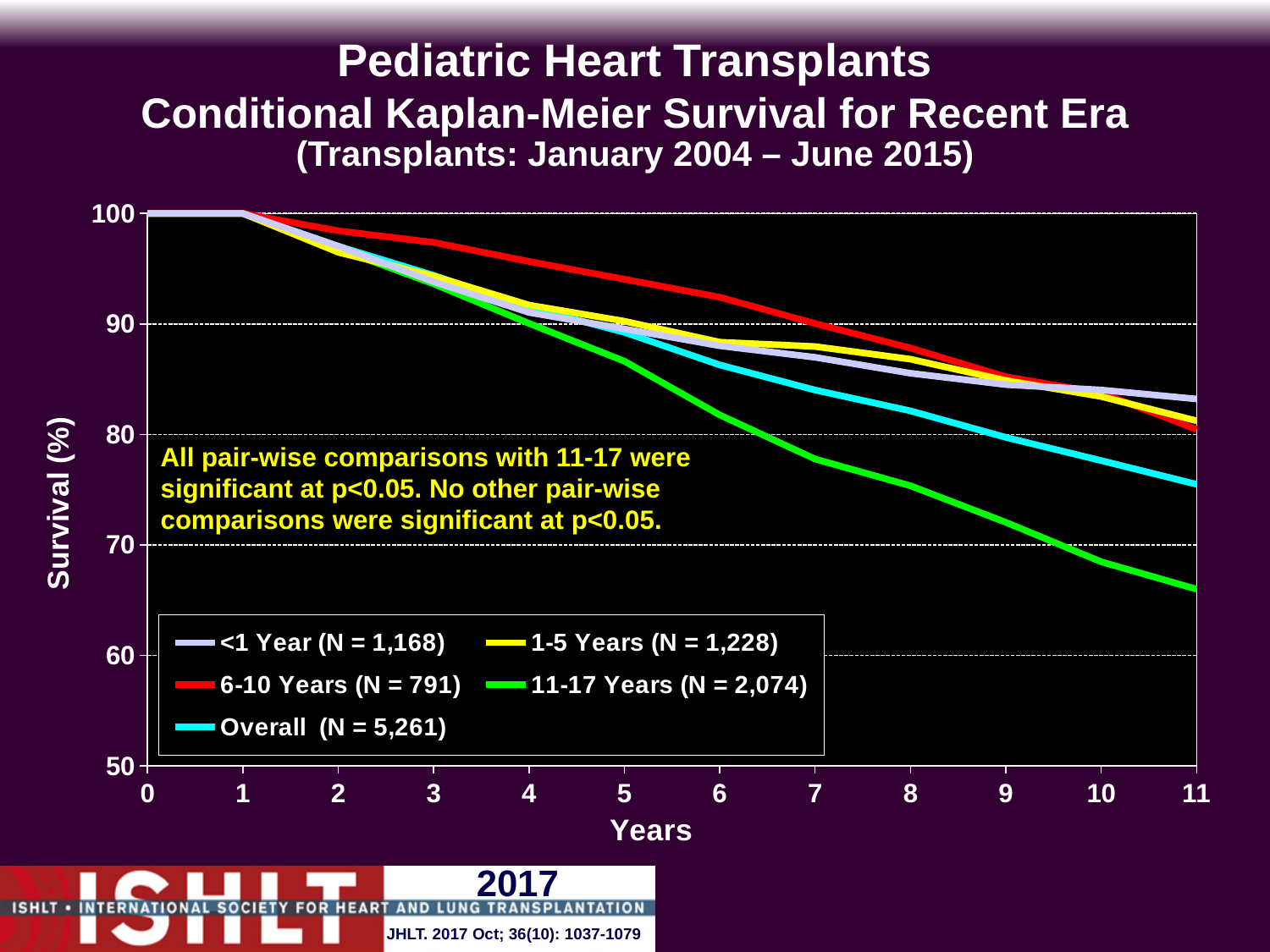
Is the survival for <1 Year at 11 years greater or less than 80? greater Is the survival for Overall at 11 years greater or less than 70? greater What is the survival (%) for all series at 0 years? 100 Which series has the highest survival at 5 years? 6-10 Years How many series does the legend list? 5 Which series has the lowest survival at 11 years? 11-17 Years At 8 years, which is larger: the survival for Overall or for 11-17 Years? Overall What kind of chart is shown on the slide? line chart What is the N shown in the legend for the Overall series? N = 5,261 Is the survival for 6-10 Years at 5 years greater or less than 90? greater Do the survival curves rise or fall as years increase? fall